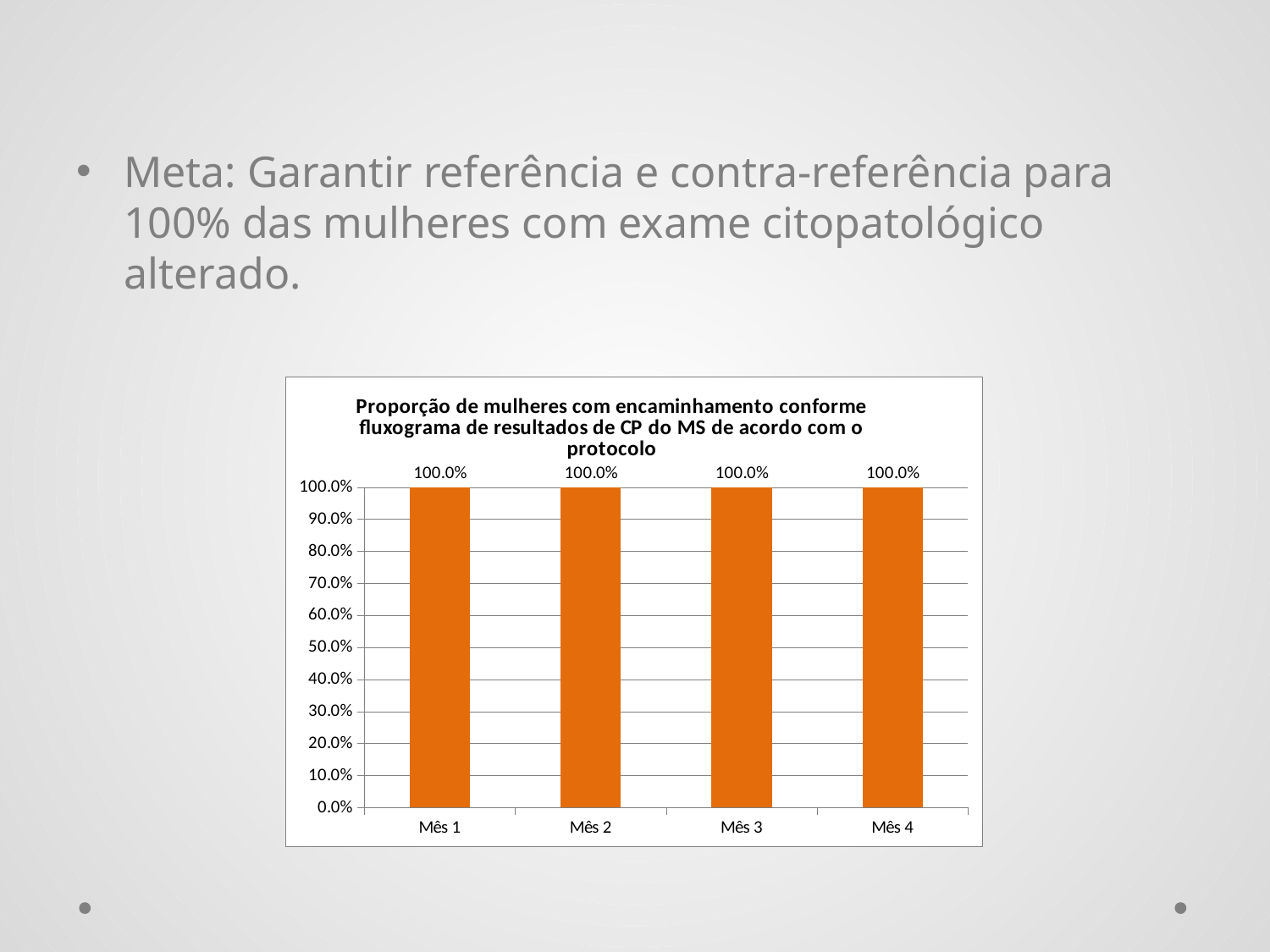
What is the value for Mês 4? 100.0% How many categories are shown on the x axis of the chart? 4 Is the value for Mês 2 greater or less than 50.0%? greater What is the value for Mês 2? 100.0% Do the values rise, fall or stay the same from Mês 1 to Mês 4? Stay the same What colour are the bars in the chart? Orange What is the difference between the values for Mês 1 and Mês 4? 0.0% What kind of chart is shown on the slide? Bar chart What is the value for Mês 3? 100.0% What is the title of the chart? Proporção de mulheres com encaminhamento conforme fluxograma de resultados de CP do MS de acordo com o protocolo What is the value for Mês 1? 100.0%